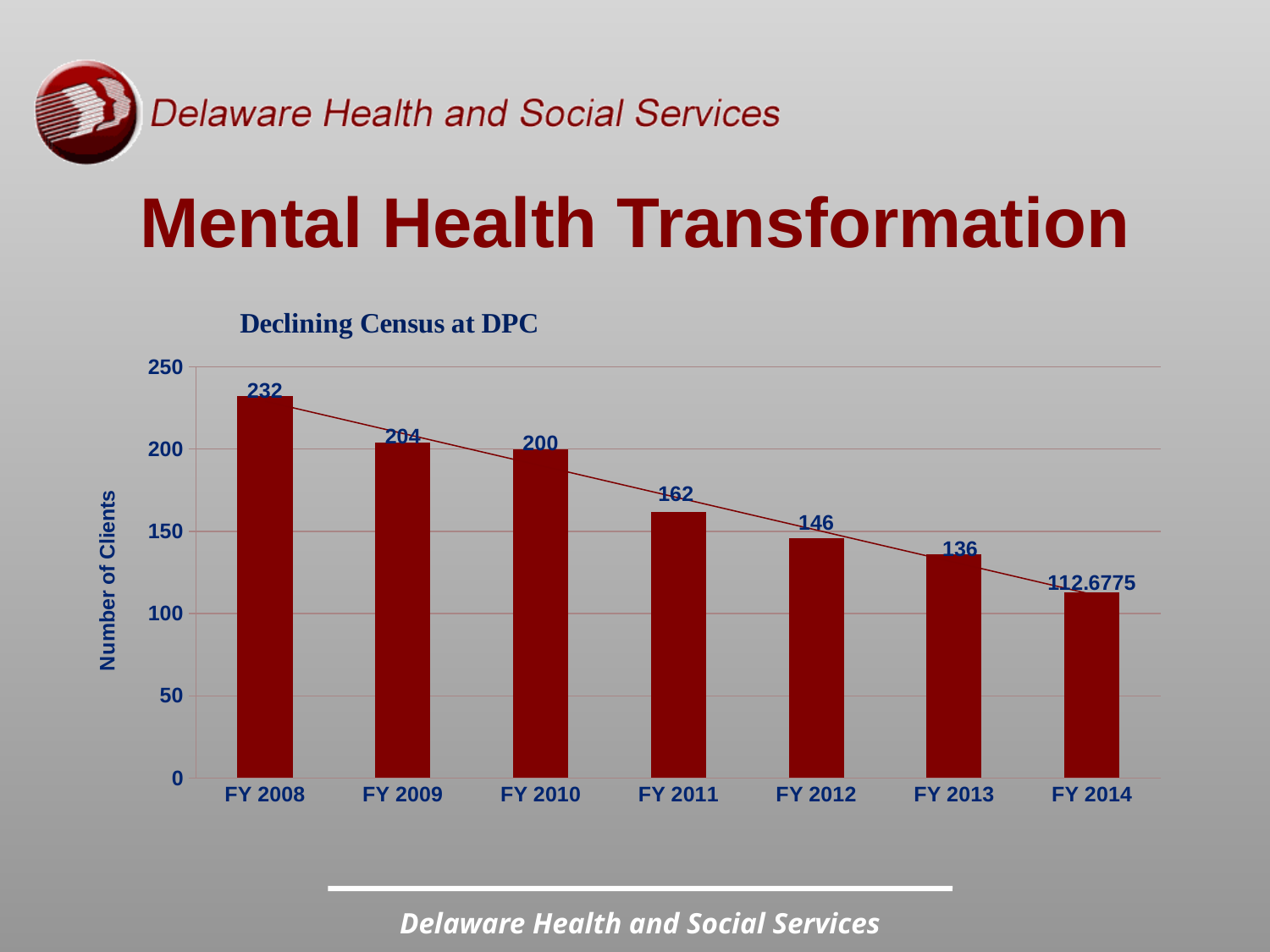
Which fiscal year has the lowest number of clients? FY 2014 What kind of chart is shown on the slide? Bar chart What is the number of clients for FY 2008? 232 Do the values rise or fall from FY 2008 to FY 2014? Fall What is the difference in number of clients between FY 2009 and FY 2010? 4 How many fiscal years are shown on the x axis? 7 Which fiscal year has the highest number of clients? FY 2008 Is the value for FY 2013 greater or less than 150? less What is the number of clients for FY 2011? 162 Which has more clients, FY 2011 or FY 2012? FY 2011 What is the difference in number of clients between FY 2008 and FY 2013? 96 What is the number of clients for FY 2014? 112.6775